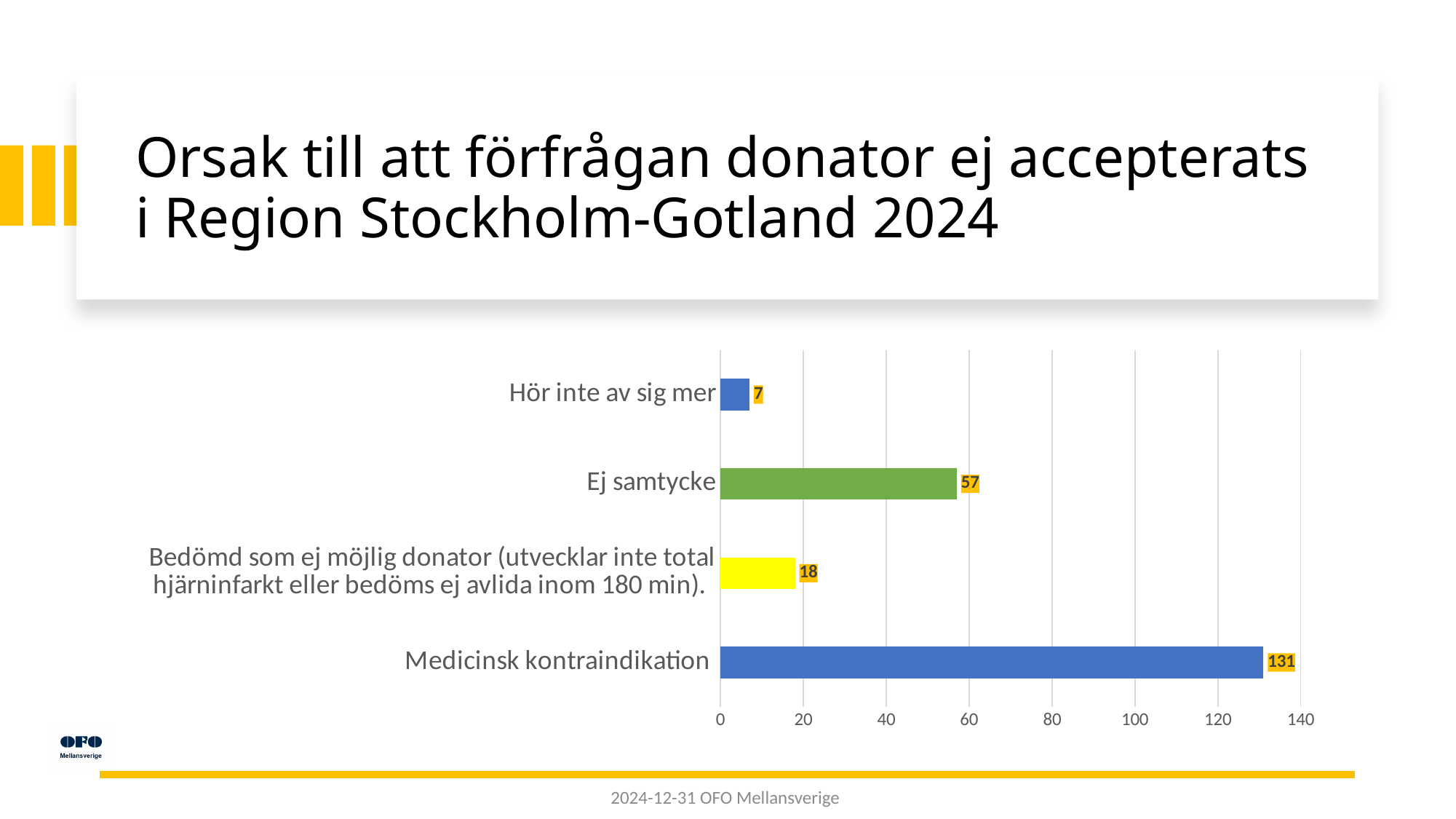
What kind of chart is shown on the slide? bar chart What colour is the bar for Ej samtycke? green How many categories are shown in the chart? 4 What is the value for Hör inte av sig mer? 7 Which category has the lowest value? Hör inte av sig mer What is the value for the category 'Bedömd som ej möjlig donator (utvecklar inte total hjärninfarkt eller bedöms ej avlida inom 180 min).'? 18 Is the value for Medicinsk kontraindikation greater or less than 120? greater What is the difference between the values for Medicinsk kontraindikation and Ej samtycke? 74 What is the value for Medicinsk kontraindikation? 131 Which is larger, the value for Ej samtycke or the value for Hör inte av sig mer? Ej samtycke What is the value for Ej samtycke? 57 Which category has the highest value? Medicinsk kontraindikation